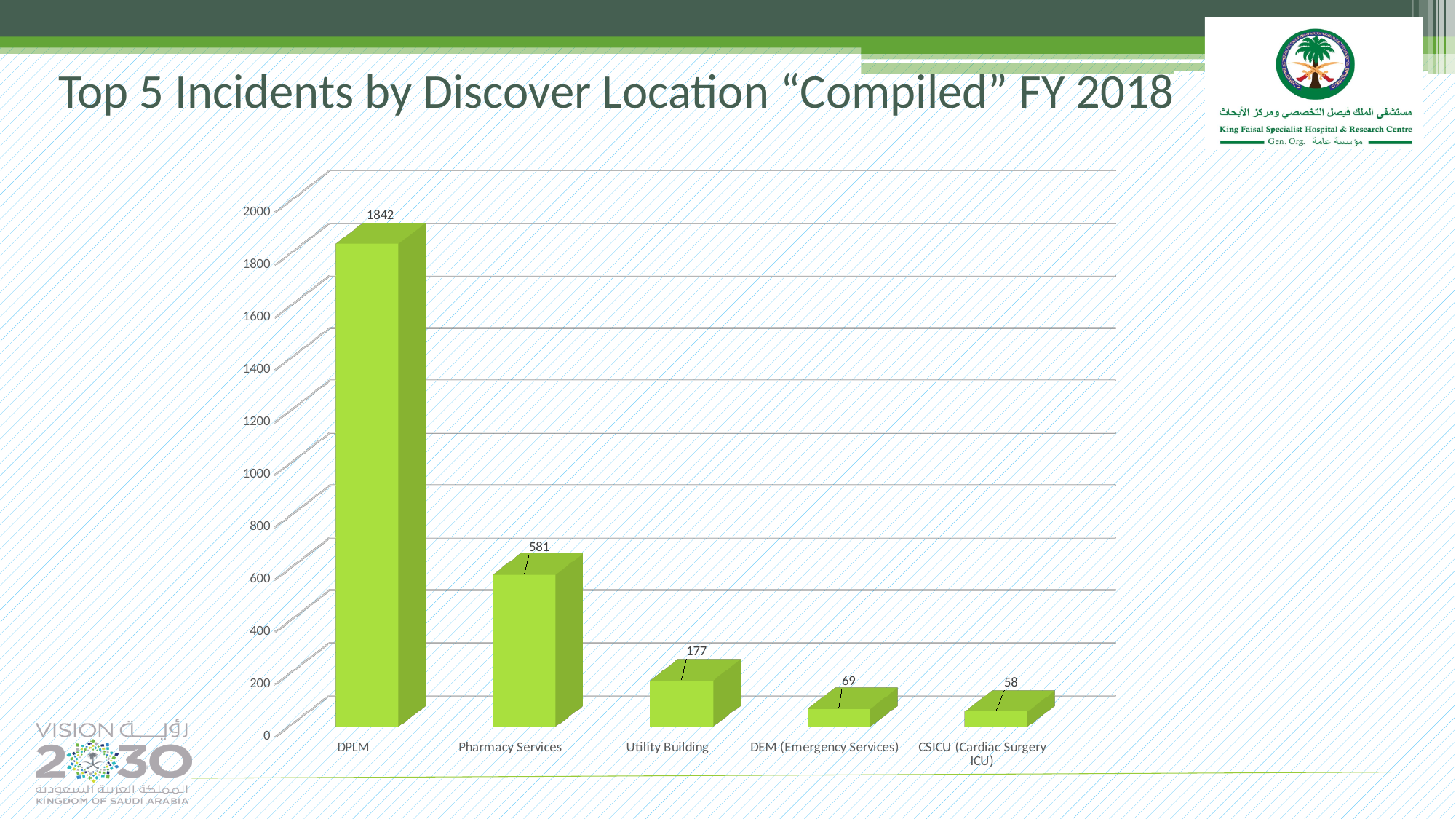
What is the value for DPLM? 1842 What is the title of the slide? Top 5 Incidents by Discover Location “Compiled” FY 2018 What is the value for DEM (Emergency Services)? 69 What is the value for Utility Building? 177 Which location has the lowest number of incidents? CSICU (Cardiac Surgery ICU) Which is larger, the value for Utility Building or the value for DEM (Emergency Services)? Utility Building What kind of chart is shown on the slide? bar chart Is the value for Pharmacy Services greater or less than 400? greater What is the difference between the values for DPLM and Pharmacy Services? 1261 What is the value for Pharmacy Services? 581 Which location has the highest number of incidents? DPLM How many locations are shown on the chart? 5